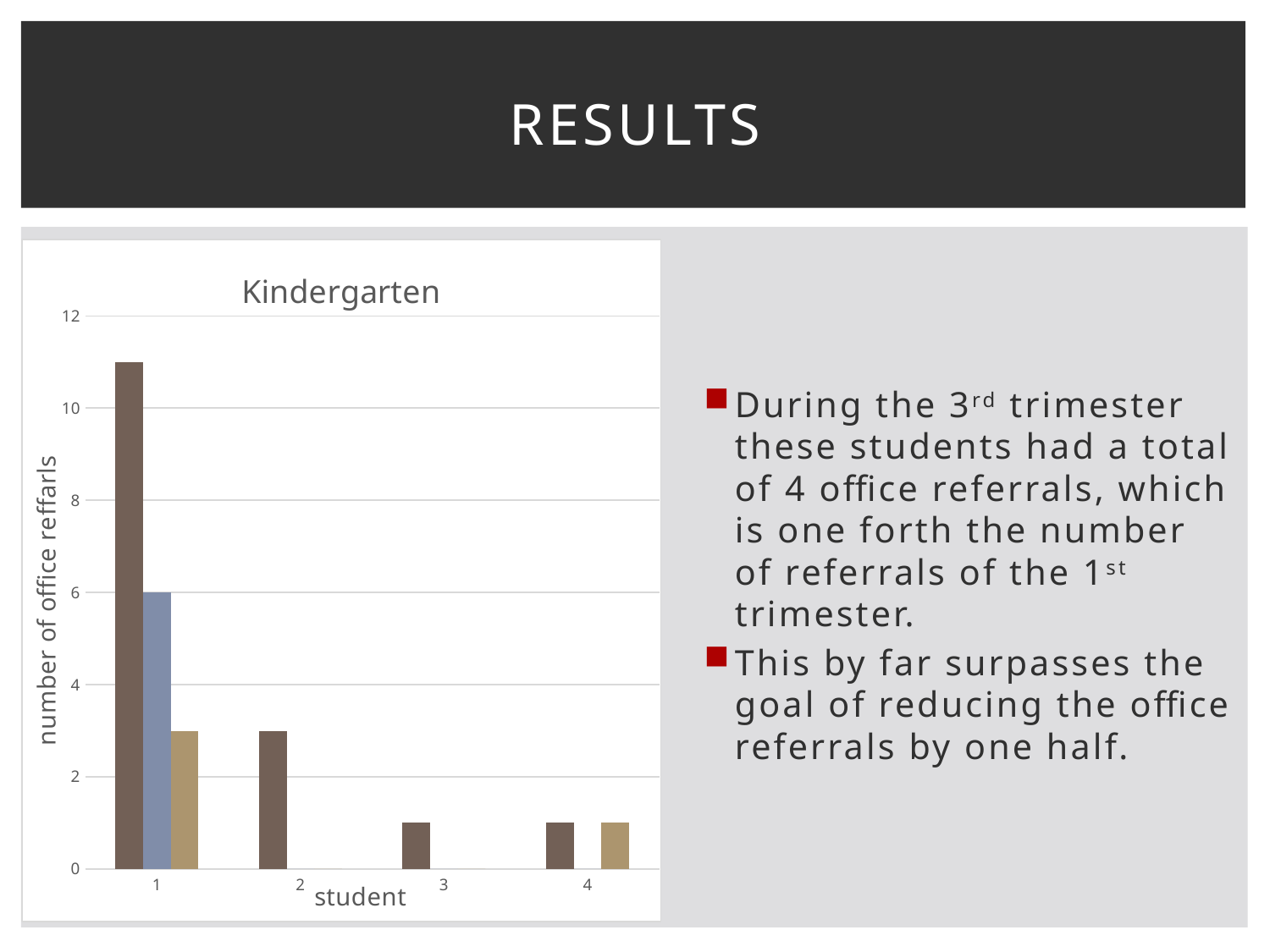
Which has a taller tallest bar, student 1 or student 2? student 1 Is the tallest bar for student 1 greater or less than 10? greater What is the label on the x axis of the chart? student Is the tallest bar for student 3 greater or less than 2? less Is the tallest bar for student 2 greater or less than 4? less What is the title of the chart? Kindergarten How many bars are plotted for student 1? 3 What kind of chart is shown on the slide? bar chart Which student has the tallest bar in the chart? 1 What value does the blue bar for student 1 reach? 6 How many students (categories) are shown on the x axis? 4